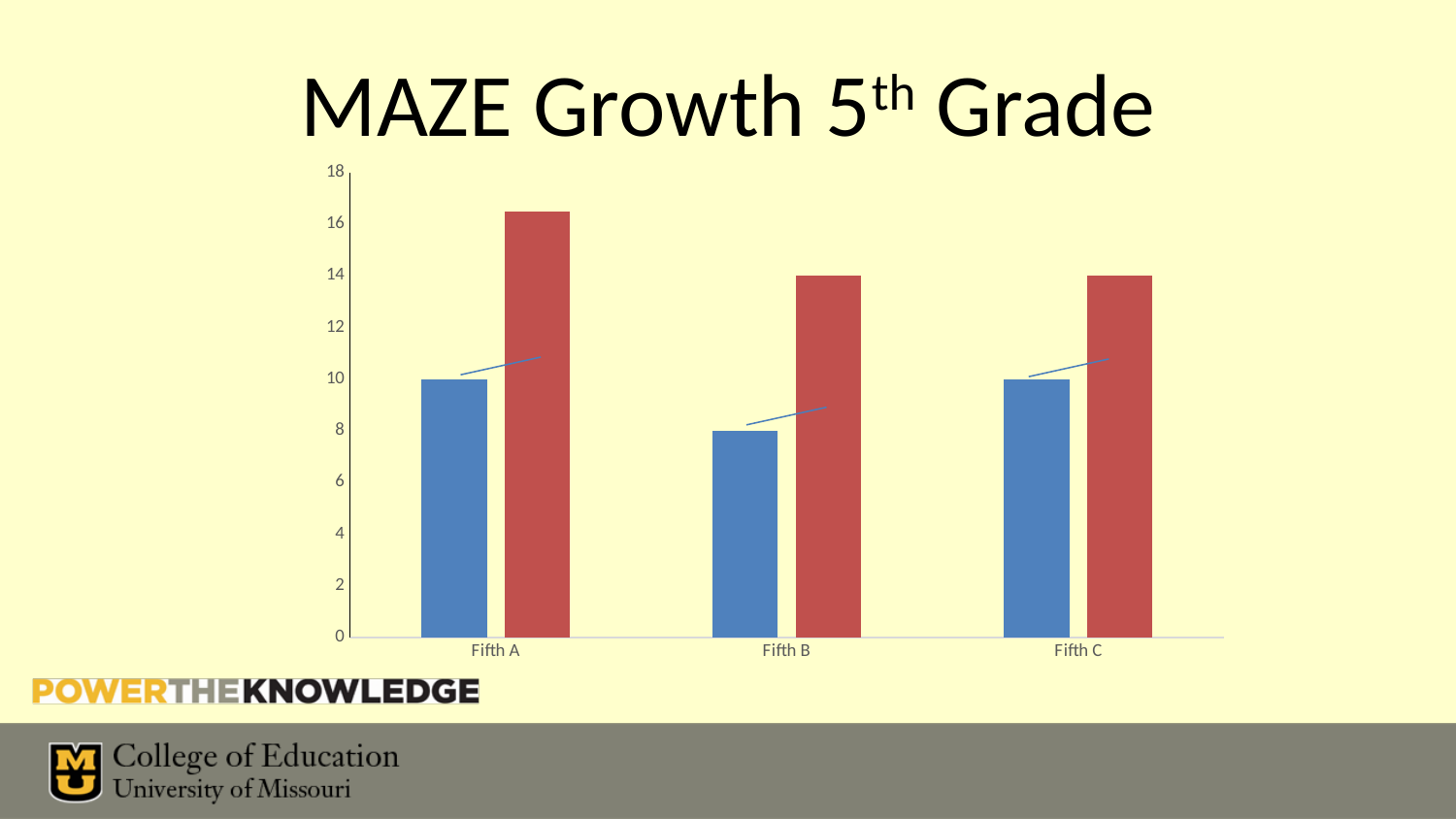
Is the red bar for Fifth A greater or less than 16? greater Is the red bar for Fifth C greater or less than 12? greater Which category has the shortest blue bar? Fifth B Which is taller, the red bar for Fifth A or the red bar for Fifth B? the red bar for Fifth A Which category has the tallest red bar? Fifth A Is the blue bar for Fifth C greater or less than 12? less What is the title of the chart? MAZE Growth 5th Grade How many bars are shown for each category? 2 How many categories are shown on the x axis? 3 What kind of chart is shown on the slide? bar chart For Fifth B, which bar is taller, the blue bar or the red bar? the red bar